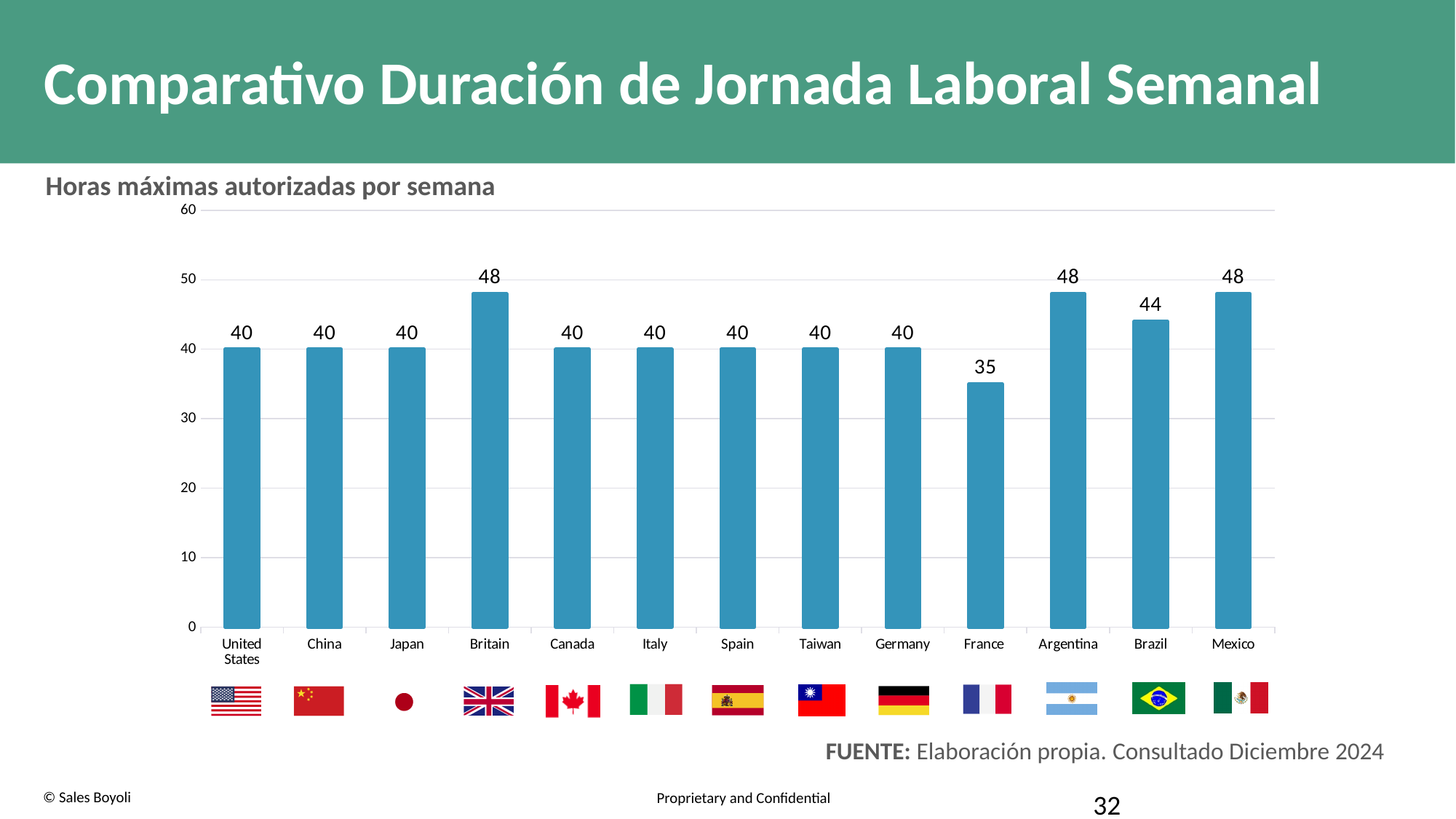
What is the value for France? 35 What is the value for Britain? 48 What is the value for Germany? 40 What is the difference between the values for Brazil and Canada? 4 How many countries are shown in the chart? 13 Which country has the lowest value? France What is the value for Brazil? 44 What is the subtitle shown above the chart? Horas máximas autorizadas por semana Which is larger, the value for Argentina or the value for Brazil? Argentina What is the difference between the values for Mexico and France? 13 What kind of chart is shown on the slide? Bar chart Which is larger, the value for France or the value for Japan? Japan